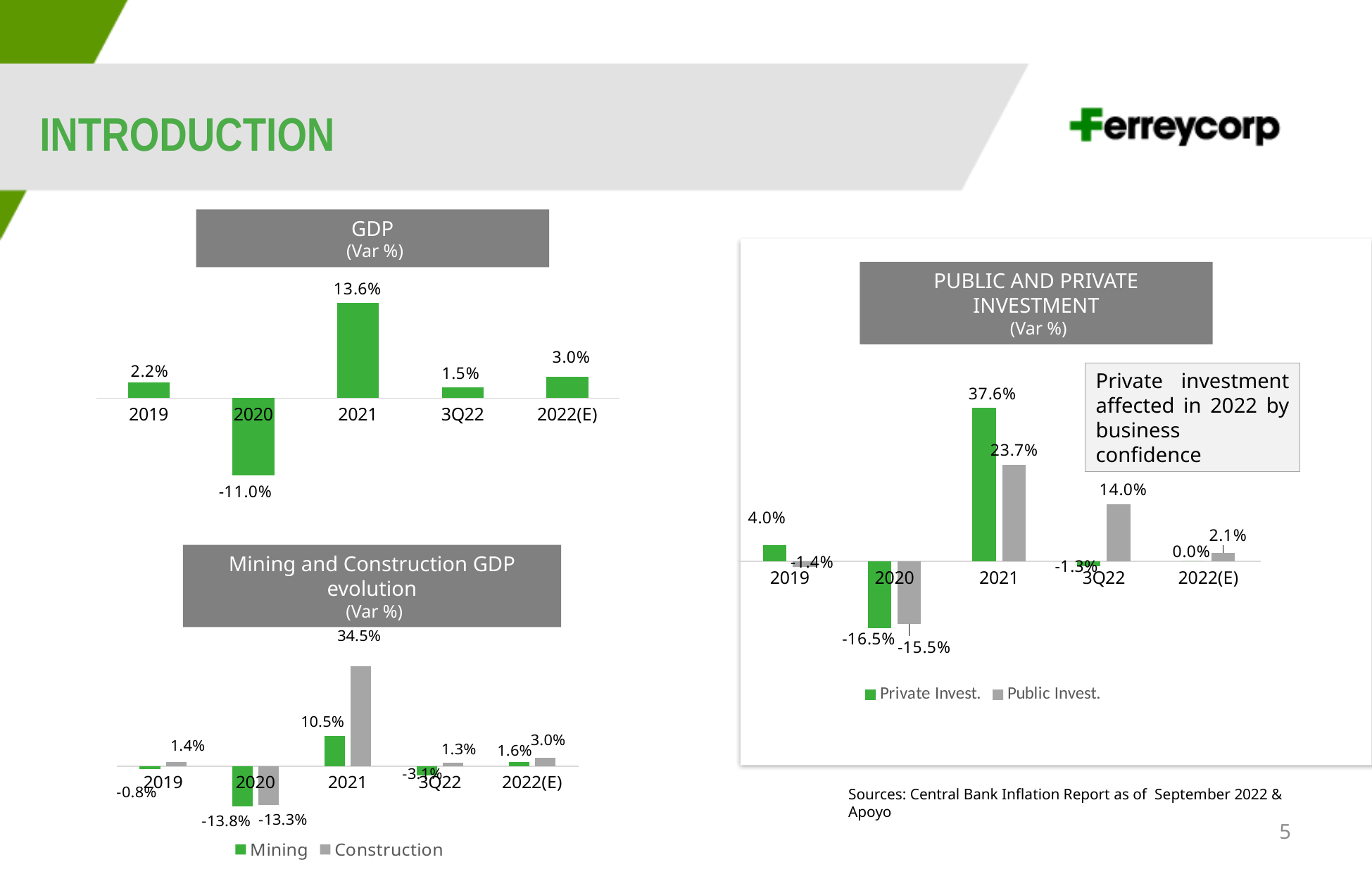
In the GDP (Var %) chart, what is the difference between the 2022(E) value and the 3Q22 value? 1.5% In the Public and Private Investment chart, what is the Public Invest. value for 3Q22? 14.0% In the Public and Private Investment chart, what is the Private Invest. value for 2021? 37.6% In the Mining and Construction GDP evolution chart, what is the Construction value for 2021? 34.5% What type of chart is the Public and Private Investment chart? Bar chart In the Public and Private Investment chart, what is the difference between Private Invest. and Public Invest. in 2021? 13.9% In the Mining and Construction GDP evolution chart, how many series does the legend list? 2 In the GDP (Var %) chart, which year has the lowest value? 2020 In the GDP (Var %) chart, how many categories are shown on the x axis? 5 In the Mining and Construction GDP evolution chart, what is the Mining value for 2020? -13.8% In the GDP (Var %) chart, what is the value for 2021? 13.6% In the Mining and Construction GDP evolution chart, which is larger for 2022(E): Mining or Construction? Construction